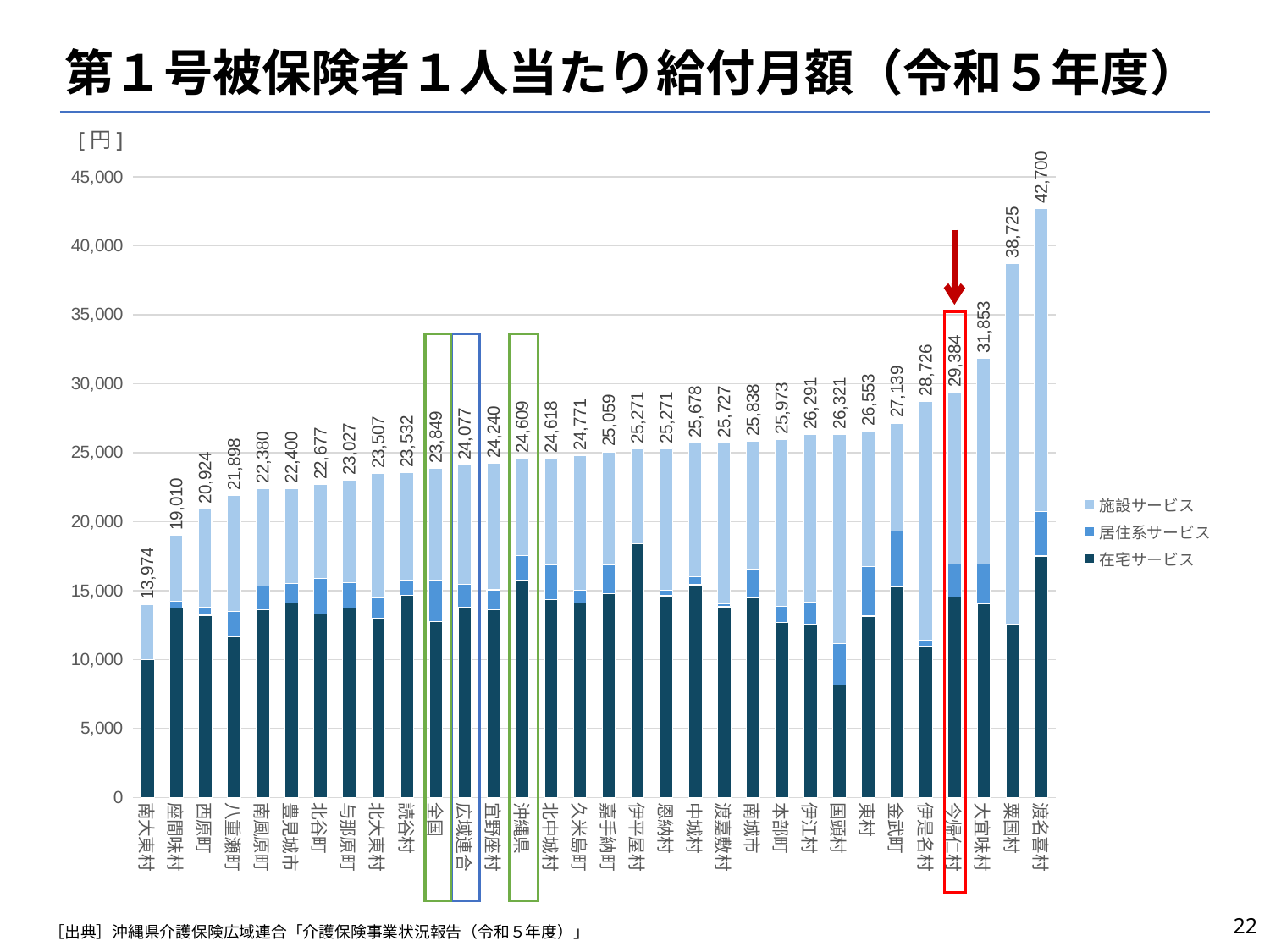
Do the total values rise or fall from left to right along the x axis? rise Is the 在宅サービス value for 伊平屋村 greater or less than 15,000? greater What is the total value labeled for 沖縄県? 24,609 What is the total value labeled for 今帰仁村? 29,384 Which has a larger total, 広域連合 or 全国? 広域連合 Which category has the highest total value? 渡名喜村 Which category has the lowest total value? 南大東村 How many series does the legend list? 3 What is the total value labeled for 全国? 23,849 What kind of chart is shown on the slide? stacked bar chart How many categories are shown on the x axis? 32 What is the difference between the totals for 渡名喜村 and 粟国村? 3,975